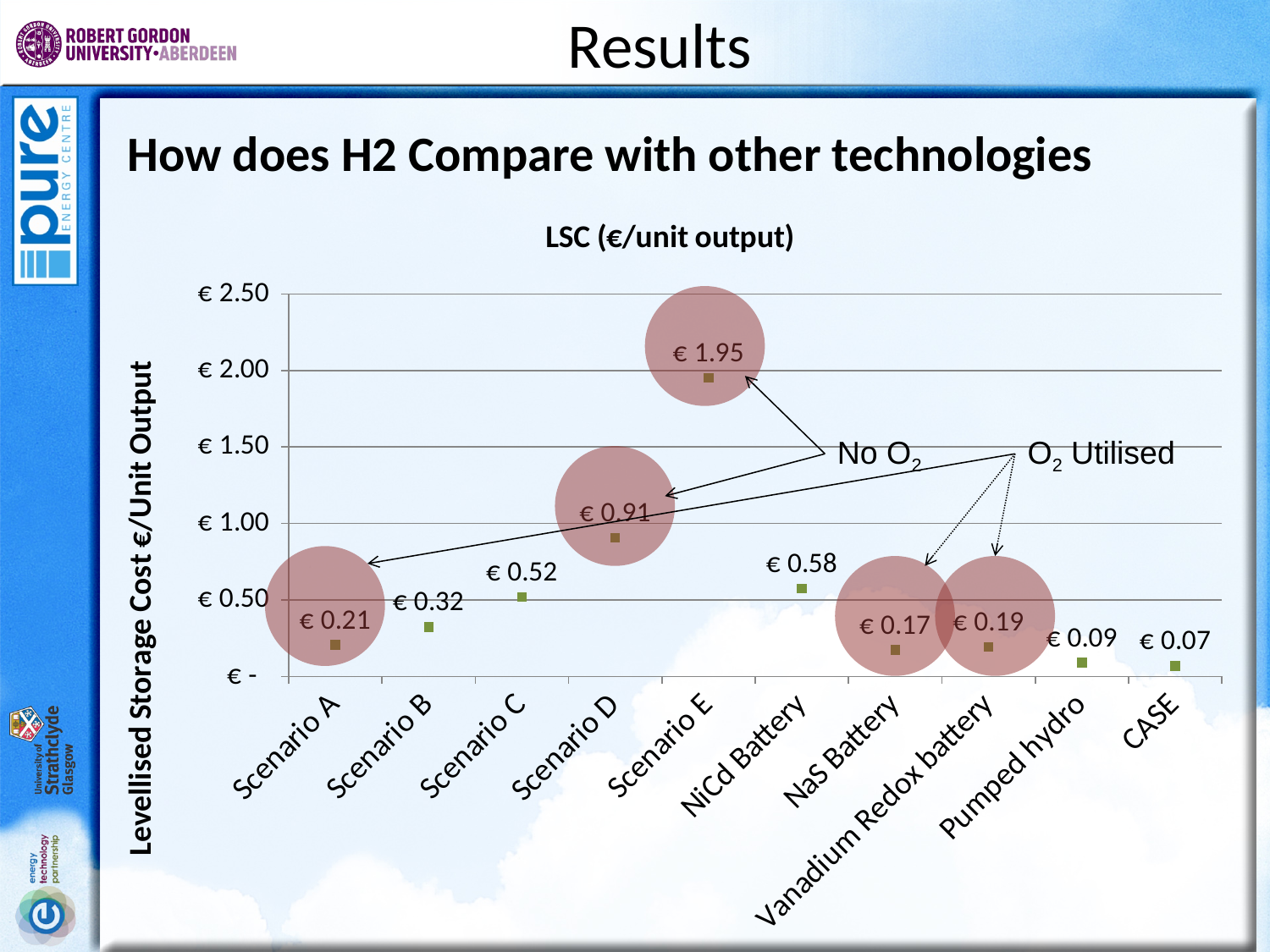
How many categories are plotted on the x axis? 10 What is the LSC value for Vanadium Redox battery? € 0.19 Which category has the highest LSC value? Scenario E What is the LSC value for NiCd Battery? € 0.58 Which has a higher LSC value, Scenario C or NiCd Battery? NiCd Battery Which category has the lowest LSC value? CASE What is the difference between the LSC values for Scenario E and Scenario D? € 1.04 What is the LSC value for Scenario E? € 1.95 What is the LSC value for Pumped hydro? € 0.09 What is the label of the vertical axis? Levellised Storage Cost €/Unit Output What is the title of the chart? LSC (€/unit output) Is the LSC value for Scenario D greater or less than € 1.00? less